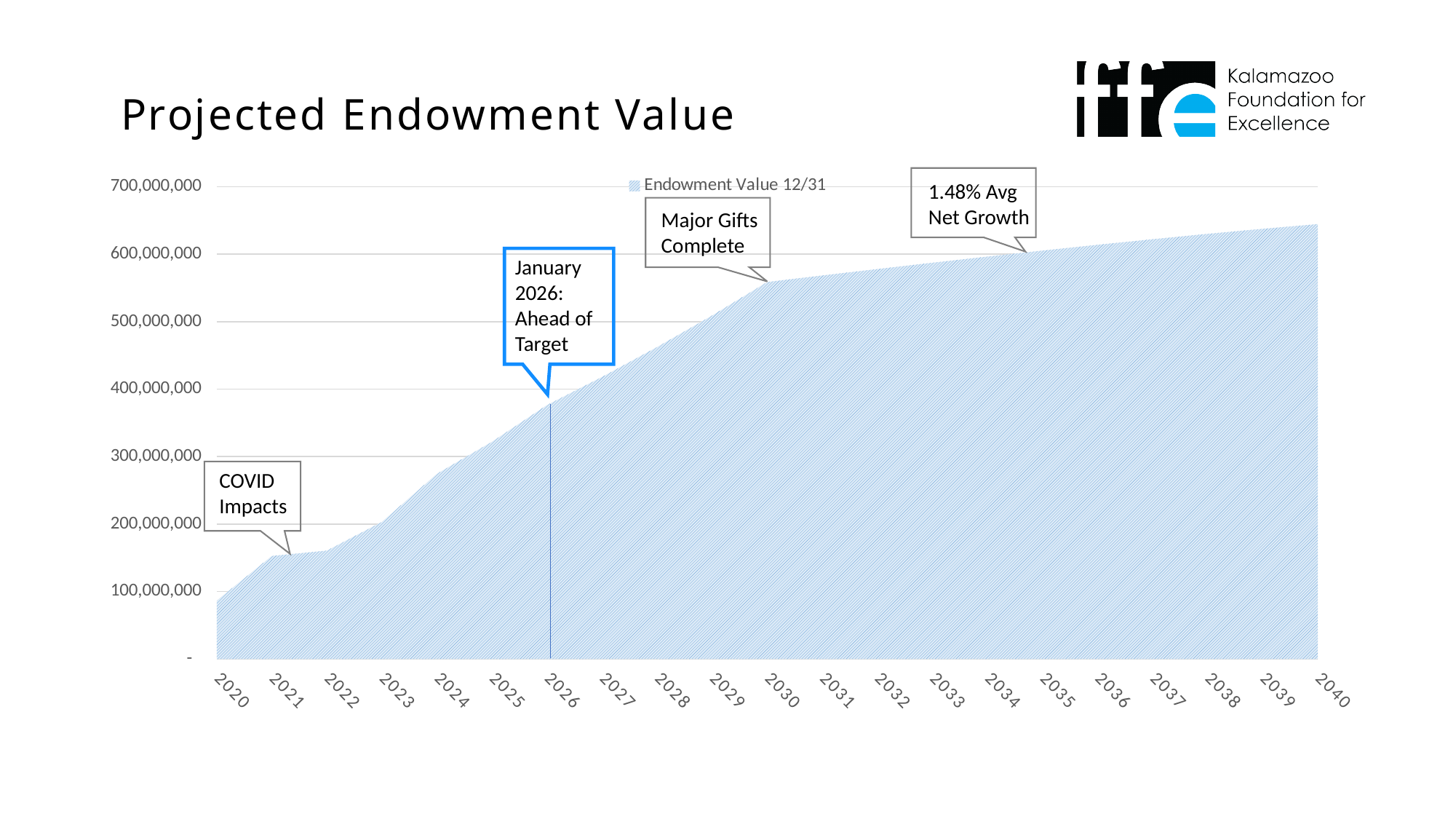
Is the endowment value for 2030 greater or less than 500,000,000? greater What kind of chart is shown on the slide? Area chart What is the title of the chart? Projected Endowment Value Which year has the highest endowment value? 2040 What series name does the legend show? Endowment Value 12/31 Which year has the lowest endowment value? 2020 Is the endowment value for 2040 greater or less than 600,000,000? greater Is the endowment value for 2020 greater or less than 100,000,000? less How many years are shown along the x axis? 21 Do the endowment values rise or fall from 2020 to 2040? Rise How many series does the legend list? 1